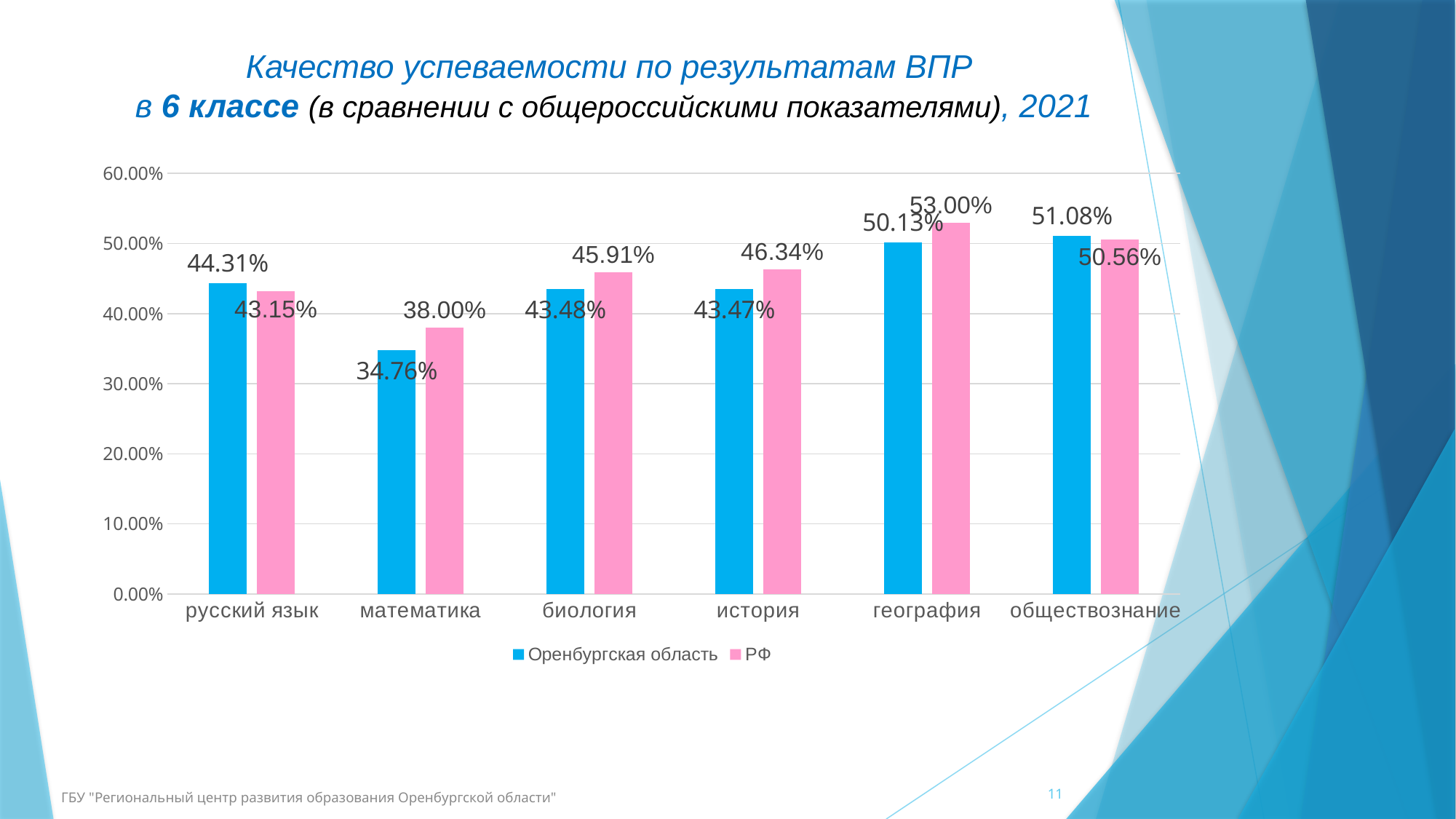
What kind of chart is shown on the slide? bar chart What is the value for Оренбургская область in математика? 34.76% Is the value for Оренбургская область in география greater or less than 50.00%? greater What is the difference between the РФ and Оренбургская область values in математика? 3.24% What is the value for РФ in история? 46.34% What is the value for РФ in география? 53.00% Which subject has the lowest value for РФ? математика How many series does the legend list? 2 How many subjects are shown on the x axis? 6 In русский язык, which series has the larger value, Оренбургская область or РФ? Оренбургская область Which subject has the highest value for Оренбургская область? обществознание What is the value for Оренбургская область in обществознание? 51.08%